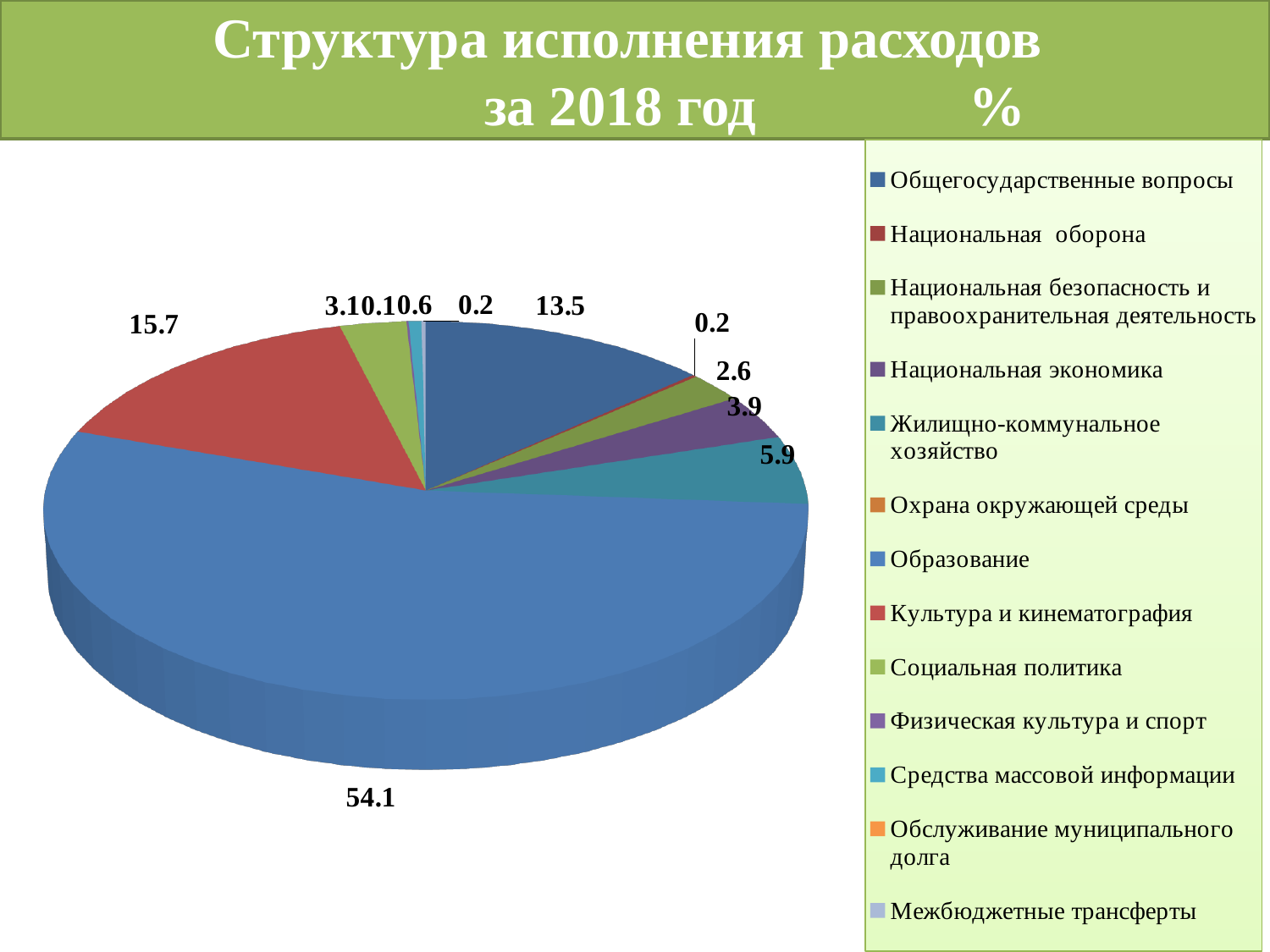
Which category has the largest share of the pie? Образование Which is larger, Культура и кинематография or Общегосударственные вопросы? Культура и кинематография What is the value for Жилищно-коммунальное хозяйство? 5.9 What is the value for Образование? 54.1 What kind of chart is shown on the slide? pie chart What is the value for Национальная экономика? 3.9 What is the title of the chart? Структура исполнения расходов за 2018 год % What is the value for Общегосударственные вопросы? 13.5 What is the value for Национальная безопасность и правоохранительная деятельность? 2.6 What is the difference between the values for Образование and Культура и кинематография? 38.4 What is the value for Культура и кинематография? 15.7 How many categories does the legend list? 13